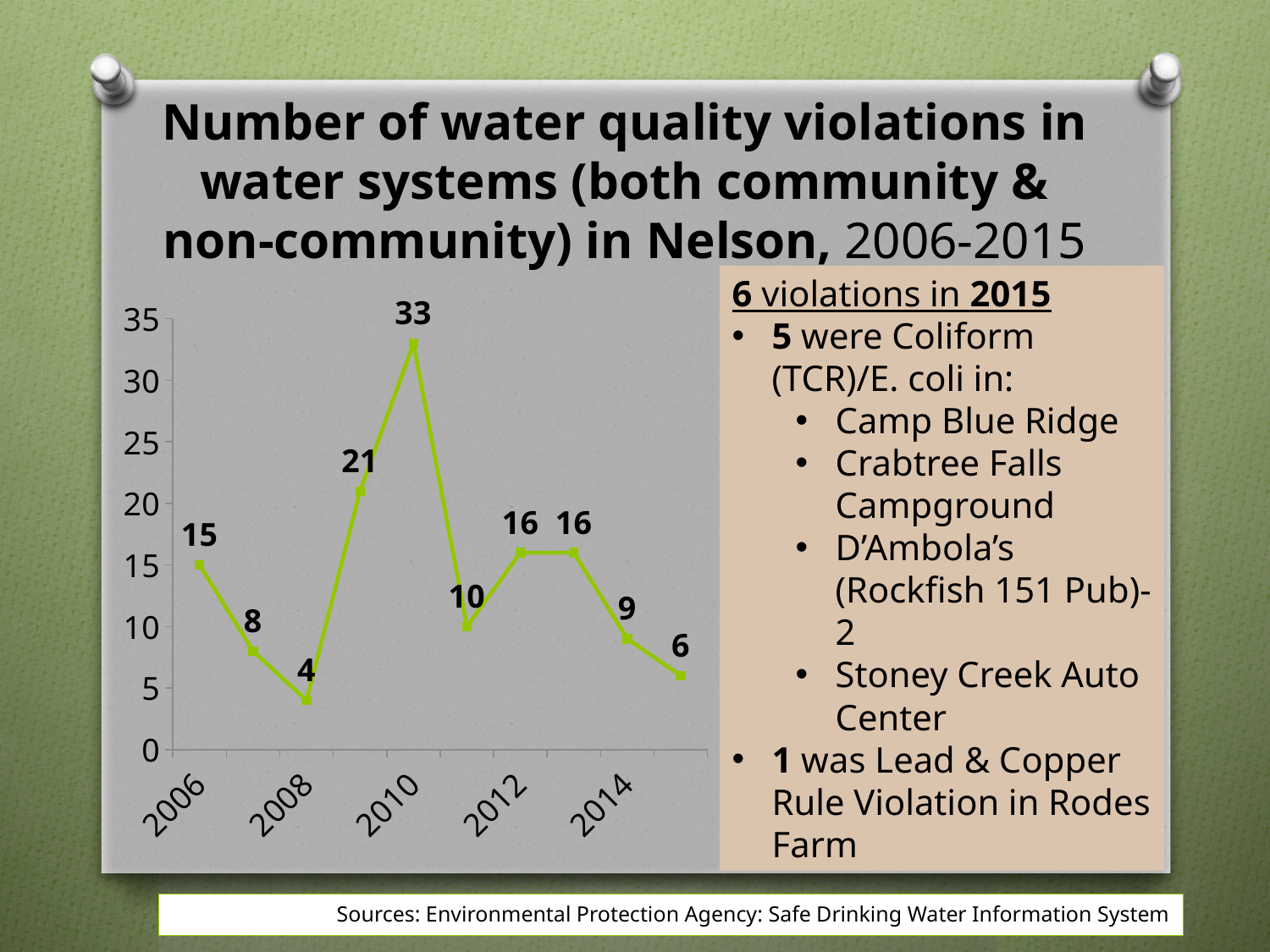
How many water quality violations were there in 2008? 4 How many data points are plotted on the line chart? 10 How many water quality violations were there in 2014? 9 Which year had the lowest number of water quality violations? 2008 What is the difference between the number of violations in 2010 and in 2008? 29 How many water quality violations were there in 2012? 16 How many water quality violations were there in 2015? 6 Which year had the highest number of water quality violations? 2010 How many water quality violations were there in 2006? 15 How many water quality violations were there in 2010? 33 Which year had more water quality violations, 2006 or 2014? 2006 What kind of chart is shown on the slide? line chart